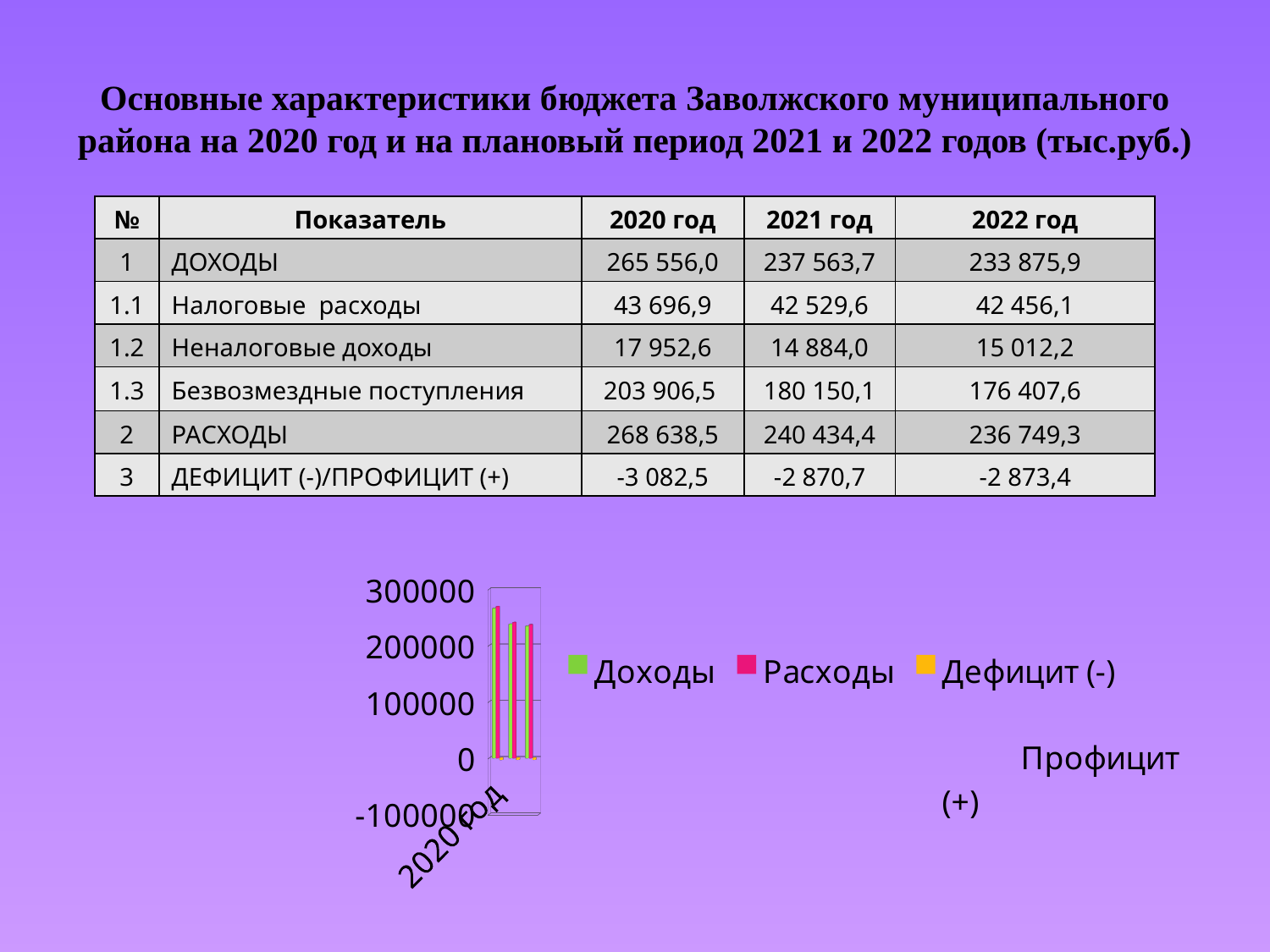
How many series does the chart's legend list? 3 What kind of chart is shown at the bottom of the slide? bar chart Is the value for Доходы in 2020 год greater or less than 200000? greater What is the highest tick value shown on the chart's vertical axis? 300000 Is the value for Расходы in 2020 год greater or less than 300000? less Do the Доходы bars rise or fall from left to right along the x axis? fall Is the value for Доходы in 2020 год greater or less than 100000? greater Which series is shown in green in the chart's legend? Доходы Which series is shown in pink in the chart's legend? Расходы